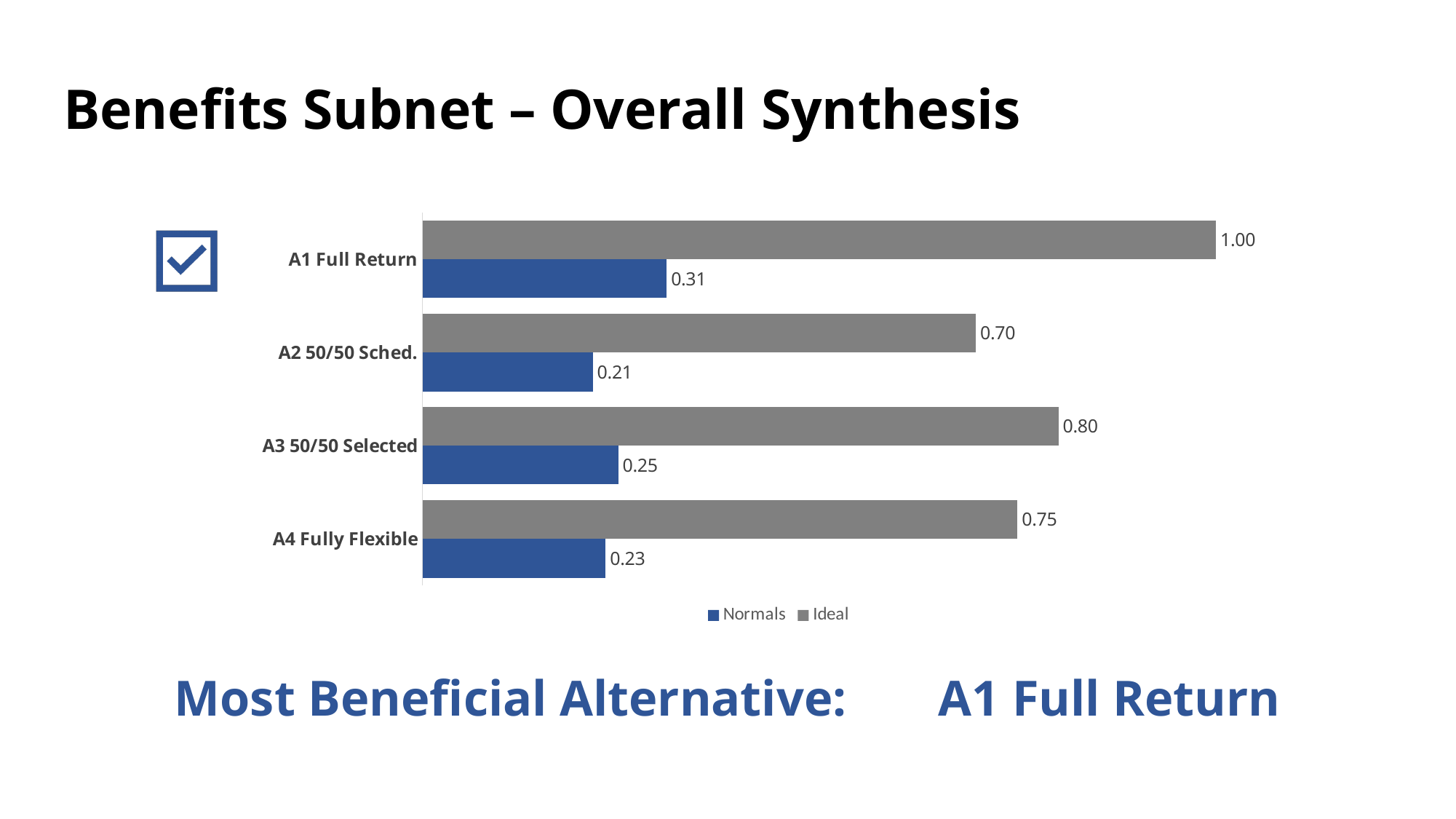
Which category has the lowest Ideal value? A2 50/50 Sched. What is the difference between the Ideal and Normals values for A1 Full Return? 0.69 Which category has the highest Normals value? A1 Full Return What is the Normals value for A4 Fully Flexible? 0.23 Which is larger, the Ideal value for A3 50/50 Selected or the Ideal value for A4 Fully Flexible? A3 50/50 Selected What is the Ideal value for A3 50/50 Selected? 0.80 What is the Ideal value for A1 Full Return? 1.00 How many categories are shown on the chart? 4 How many series does the legend list? 2 What is the Normals value for A2 50/50 Sched.? 0.21 Which series is shown in grey? Ideal What kind of chart is shown on the slide? Bar chart